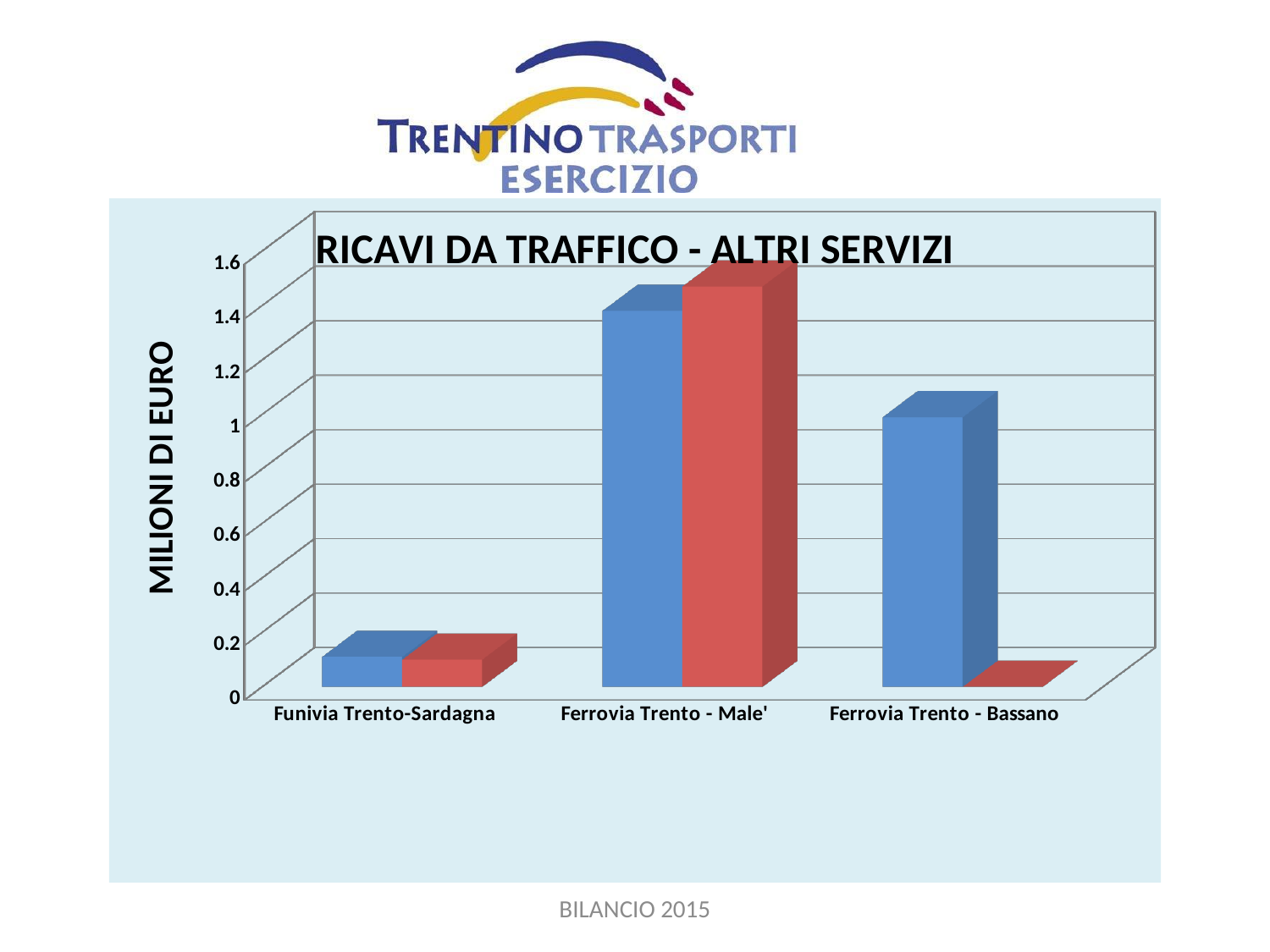
How many categories are shown on the x axis of the chart? 3 Which has the larger blue bar, Ferrovia Trento - Male' or Ferrovia Trento - Bassano? Ferrovia Trento - Male' What is the title of the chart? RICAVI DA TRAFFICO - ALTRI SERVIZI What kind of chart is shown on the slide? bar chart Is the blue bar for Funivia Trento-Sardagna greater or less than 0.4? less Is the red bar for Ferrovia Trento - Male' greater or less than 1.2? greater What is the label on the vertical axis of the chart? MILIONI DI EURO Which category has the lowest bars in the chart? Funivia Trento-Sardagna Which has the larger red bar, Funivia Trento-Sardagna or Ferrovia Trento - Male'? Ferrovia Trento - Male' Is the blue bar for Ferrovia Trento - Bassano greater or less than 1.2? less Which category has the highest bars in the chart? Ferrovia Trento - Male'